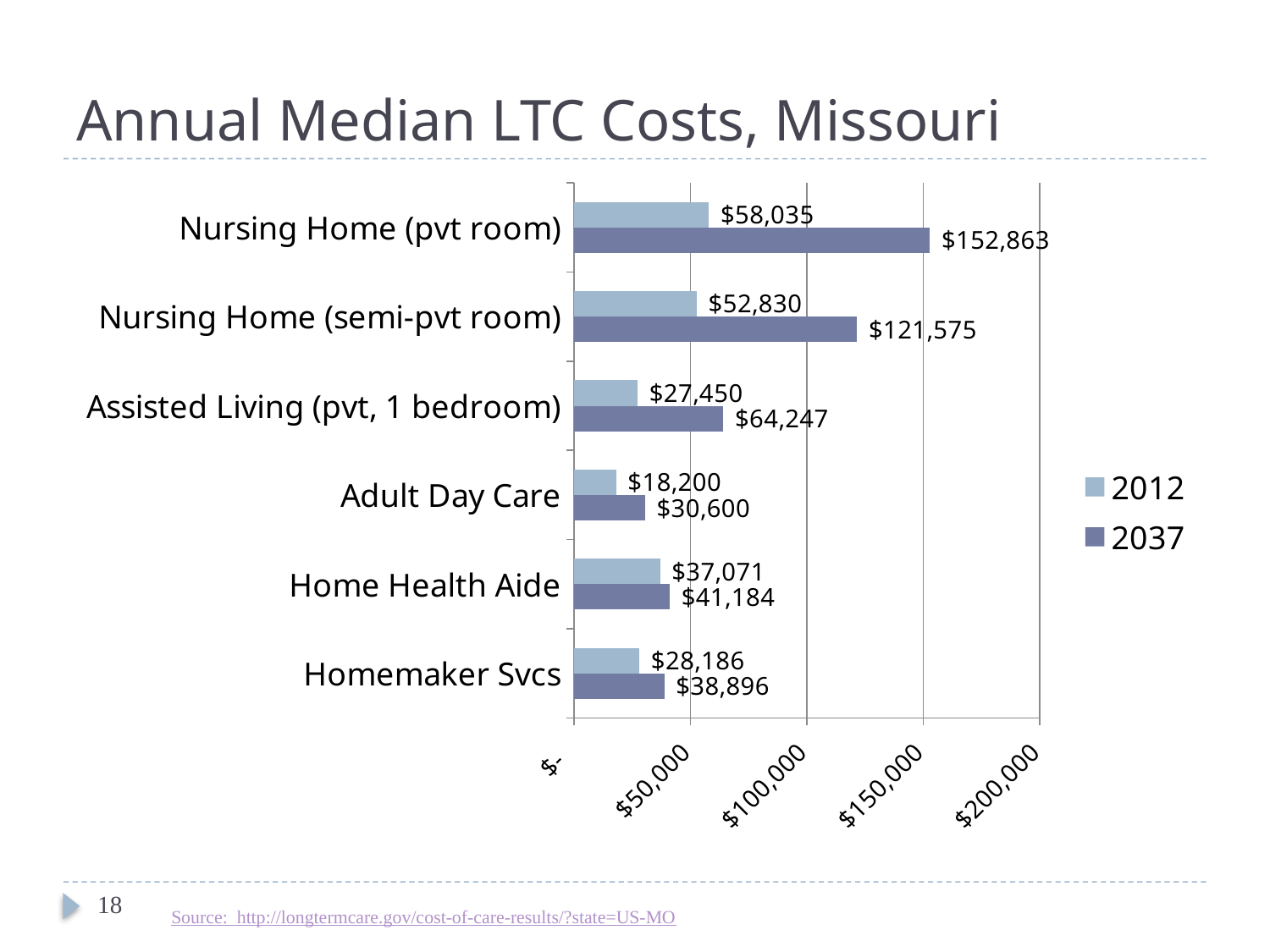
Which is larger, the 2012 value for Home Health Aide or the 2012 value for Homemaker Svcs? Home Health Aide Which category has the lowest 2012 value? Adult Day Care What is the title of the chart? Annual Median LTC Costs, Missouri What is the 2037 value for Home Health Aide? $41,184 Which category has the highest 2037 value? Nursing Home (pvt room) What kind of chart is shown on the slide? bar chart What is the 2012 value for Adult Day Care? $18,200 What is the 2037 value for Nursing Home (pvt room)? $152,863 How many categories are shown on the chart? 6 How many series does the legend list? 2 Is the 2037 value for Assisted Living (pvt, 1 bedroom) greater or less than $50,000? greater What is the difference between the 2037 and 2012 values for Nursing Home (semi-pvt room)? $68,745